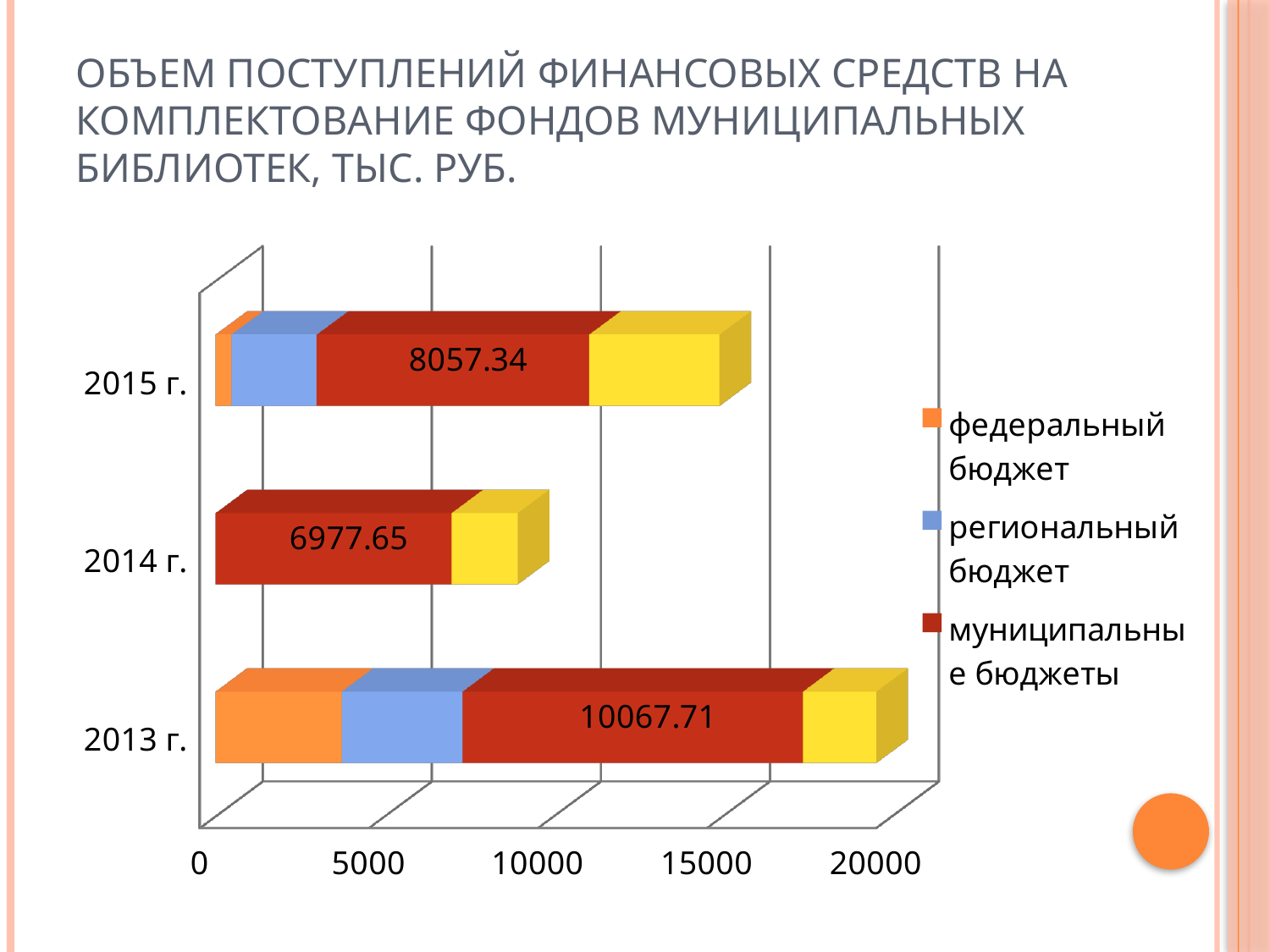
In which year is the value for муниципальные бюджеты the highest? 2013 г. What is the difference between the муниципальные бюджеты values for 2013 г. and 2014 г.? 3090.06 What is the value for муниципальные бюджеты in 2014 г.? 6977.65 What kind of chart is shown on the slide? Stacked bar chart Is the total length of the bar for 2013 г. greater or less than 15000? greater Which year has the larger value for муниципальные бюджеты, 2015 г. or 2014 г.? 2015 г. What is the value for муниципальные бюджеты in 2015 г.? 8057.34 What is the value for муниципальные бюджеты in 2013 г.? 10067.71 How many series does the legend list? 3 In which year is the value for муниципальные бюджеты the lowest? 2014 г. How many years are shown on the chart? 3 Is the value for федеральный бюджет in 2013 г. greater or less than 5000? less